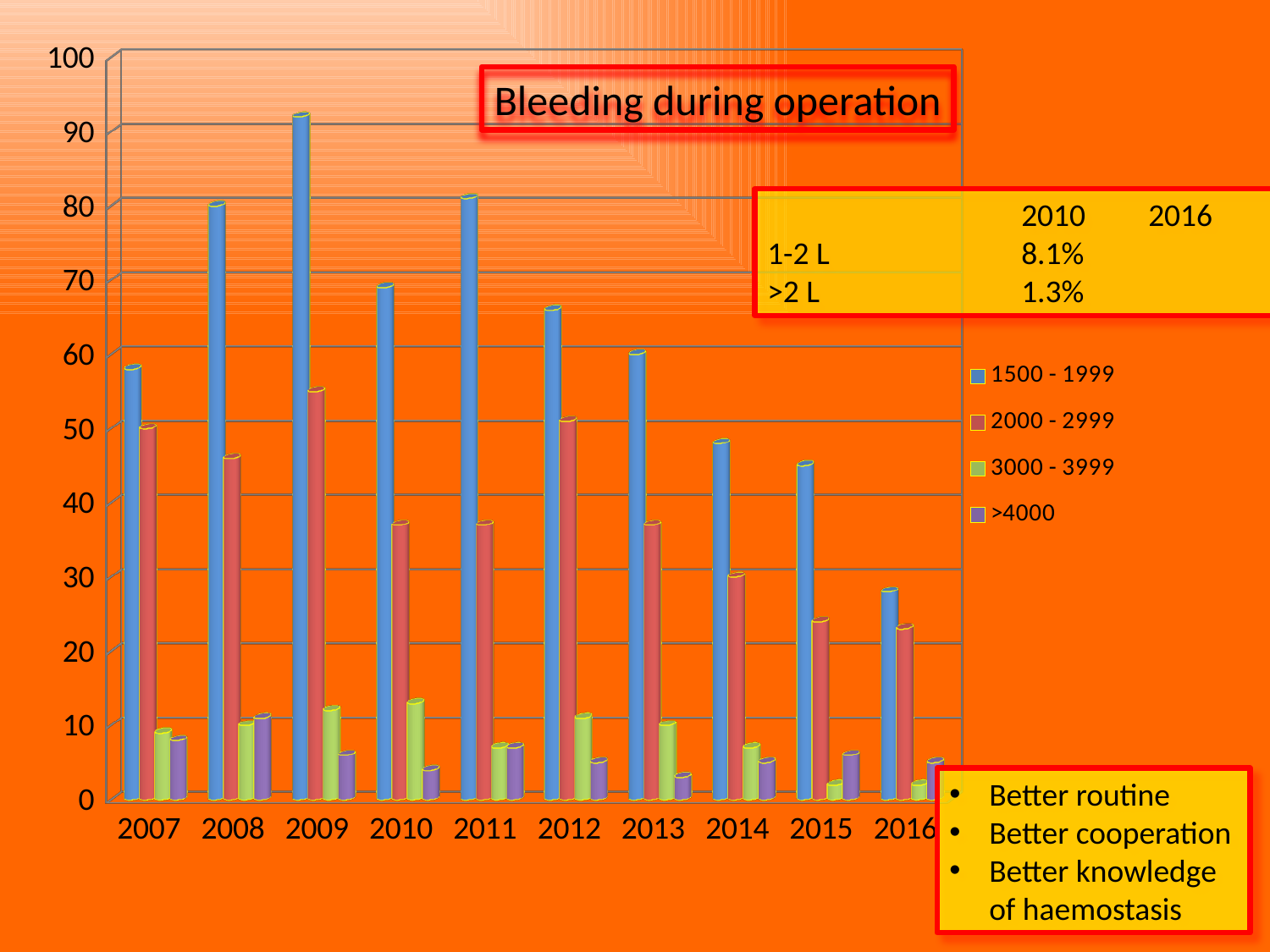
Which is larger in 2008: the 3000 - 3999 series or the 1500 - 1999 series? 1500 - 1999 Is the value for the 1500 - 1999 series in 2016 greater or less than 30? less What is the title of the chart? Bleeding during operation Is the value for the 2000 - 2999 series in 2009 greater or less than 50? greater In which year is the 1500 - 1999 series highest? 2009 What kind of chart is shown on the slide? bar chart Is the value for the 1500 - 1999 series in 2009 greater or less than 90? greater Does the 1500 - 1999 series rise or fall from 2011 to 2016? fall In which year is the 1500 - 1999 series lowest? 2016 How many series does the chart's legend list? 4 How many years are shown along the x axis of the chart? 10 Which is larger in 2012: the 1500 - 1999 series or the 2000 - 2999 series? 1500 - 1999